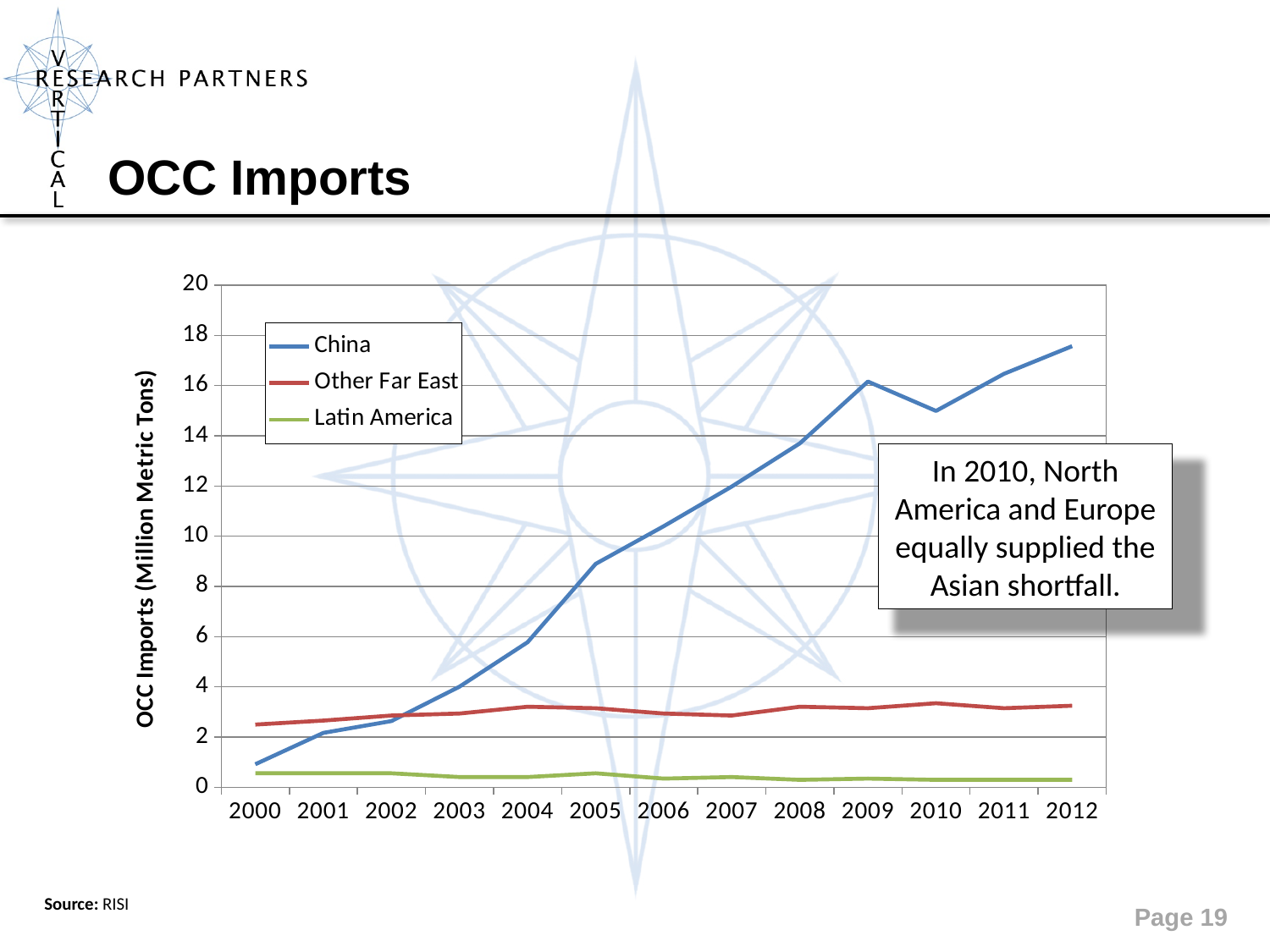
How many series does the legend list? 3 How many years are shown along the x axis? 13 What is the label on the y axis? OCC Imports (Million Metric Tons) Does the China series generally rise or fall from 2000 to 2012? rise Is the value for China in 2012 greater or less than 16? greater In 2000, which is larger: the value for China or the value for Other Far East? Other Far East Which series has the highest value in 2012? China In which year does the China series reach its highest value? 2012 Which series has the lowest value in 2012? Latin America Is the value for China in 2000 greater or less than 2? less Is the value for Latin America in 2012 greater or less than 2? less What kind of chart is shown on the slide? line chart